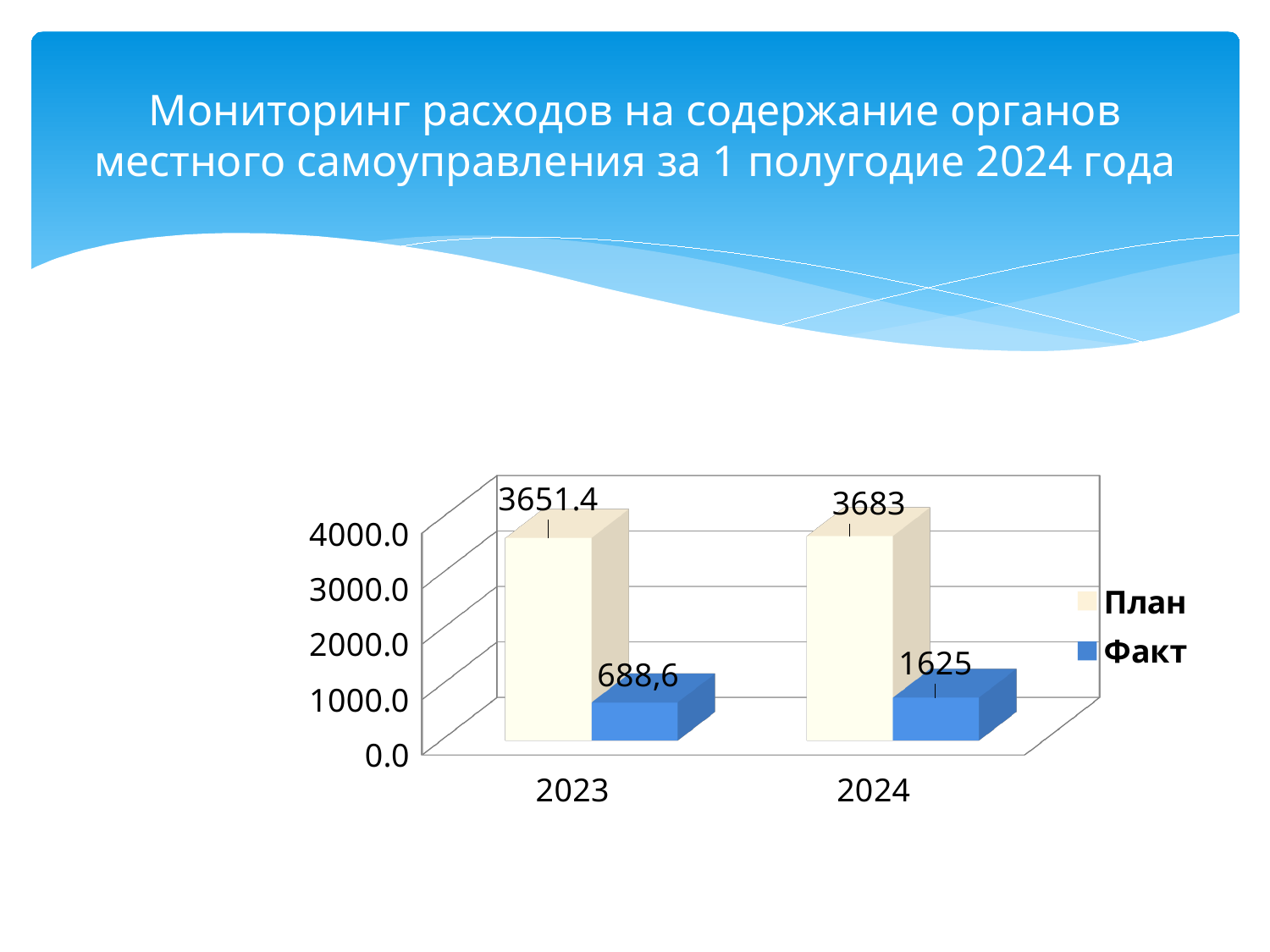
What is the План value for 2023? 3651.4 What is the План value for 2024? 3683 Which year has the higher Факт value? 2024 What is the Факт value for 2024? 1625 What is the difference between the План value for 2024 and the План value for 2023? 31.6 Which year has the lower Факт value? 2023 Is the Факт value for 2024 larger than the Факт value for 2023? Yes How many series does the legend list? 2 What is the Факт value for 2023? 688,6 What is the difference between the План and Факт values for 2024? 2058 What kind of chart is shown on the slide? Bar chart Is the Факт value for 2023 greater or less than 1000.0? less